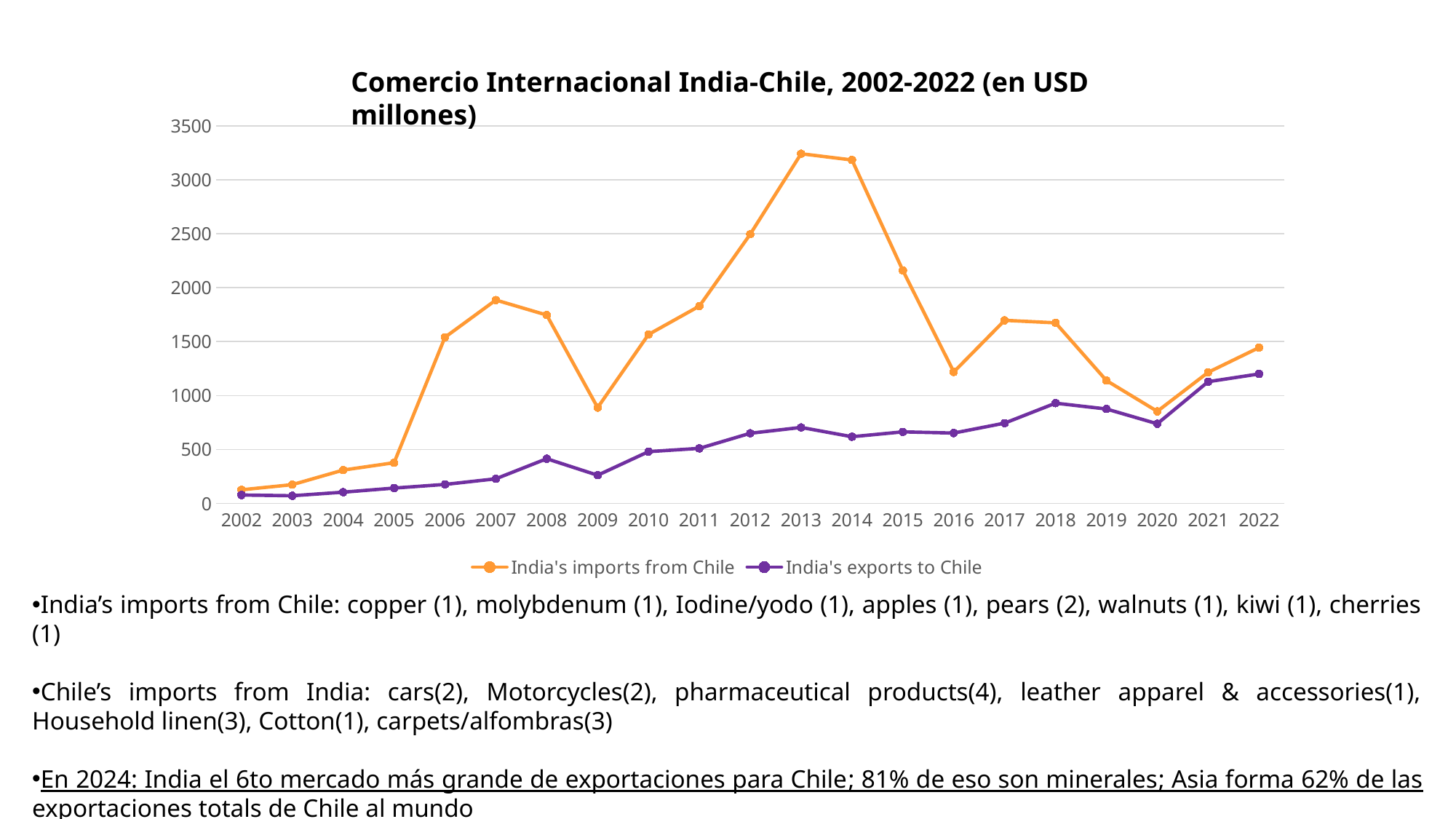
Do India's imports from Chile rise or fall between 2014 and 2016? fall What kind of chart is shown on the slide? line chart Is the value for India's exports to Chile in 2018 greater or less than 500? greater In 2012, which is larger: India's imports from Chile or India's exports to Chile? India's imports from Chile What colour is the line for India's imports from Chile? orange How many series does the legend list? 2 Is the value for India's imports from Chile in 2009 greater or less than 1000? less Is the value for India's imports from Chile in 2013 greater or less than 3000? greater How many years are plotted along the x axis? 21 In which year does India's exports to Chile reach its highest value? 2022 In which year does India's imports from Chile reach its lowest value? 2002 Overall, do India's exports to Chile rise or fall from 2002 to 2022? rise